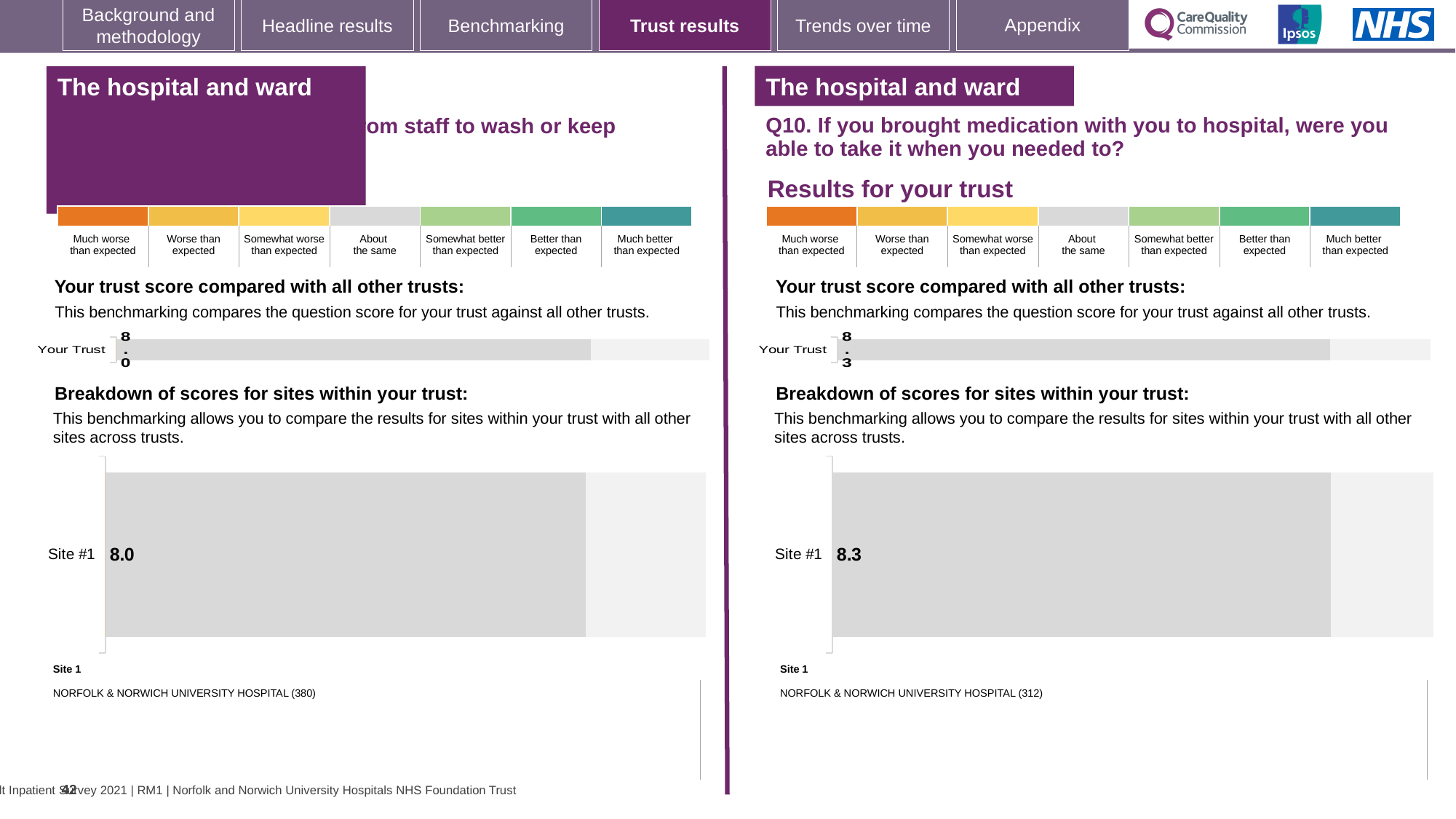
How many sites are shown in the breakdown of scores chart on the right panel (Q10)? 1 On the right panel (Q10), which site is listed as Site 1 below the breakdown chart? NORFOLK & NORWICH UNIVERSITY HOSPITAL (312) On the right panel (Q10), what is the score shown for Your Trust in the 'Your trust score compared with all other trusts' chart? 8.3 On the left panel, what score is shown for Site #1 in the breakdown of scores for sites chart? 8.0 On the right panel (Q10), what score is shown for Site #1 in the breakdown of scores for sites chart? 8.3 Which is larger: the Site #1 score on the left panel or the Site #1 score on the right panel (Q10)? Right panel (Q10) What is the difference between the Site #1 score on the right panel (Q10) and the Site #1 score on the left panel? 0.3 On the left panel, which site is listed as Site 1 below the breakdown chart? NORFOLK & NORWICH UNIVERSITY HOSPITAL (380) What kind of chart is used to show the Site #1 score on the left panel? Bar chart On the left panel, what is the score shown for Your Trust in the 'Your trust score compared with all other trusts' chart? 8.0 On the right panel (Q10), is the Your Trust score the same as the Site #1 score? Yes